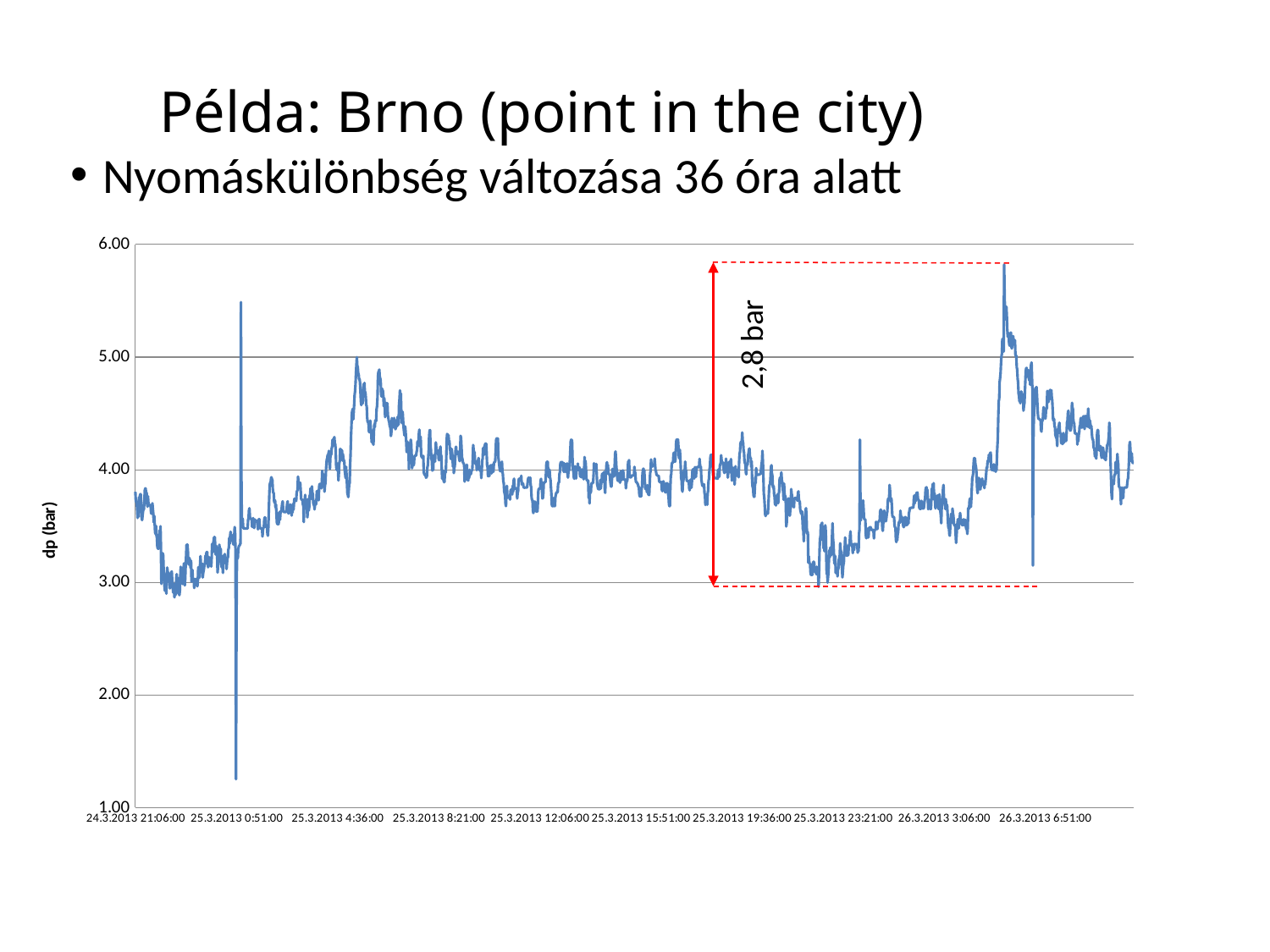
Does the line rise or fall between 25.3.2013 23:21:00 and 26.3.2013 3:06:00? rise What value does the red arrow annotation on the chart indicate? 2,8 bar Is the lowest point of the line on the chart greater or less than 2.00? less Is the highest point of the line on the chart greater or less than 5.00? greater Is the value at 25.3.2013 12:06:00 greater or less than 3.00? greater What kind of chart is shown on the slide? line chart How many lines are plotted on the chart? 1 What is the label of the vertical axis of the chart? dp (bar) What is the highest value shown on the vertical axis of the chart? 6.00